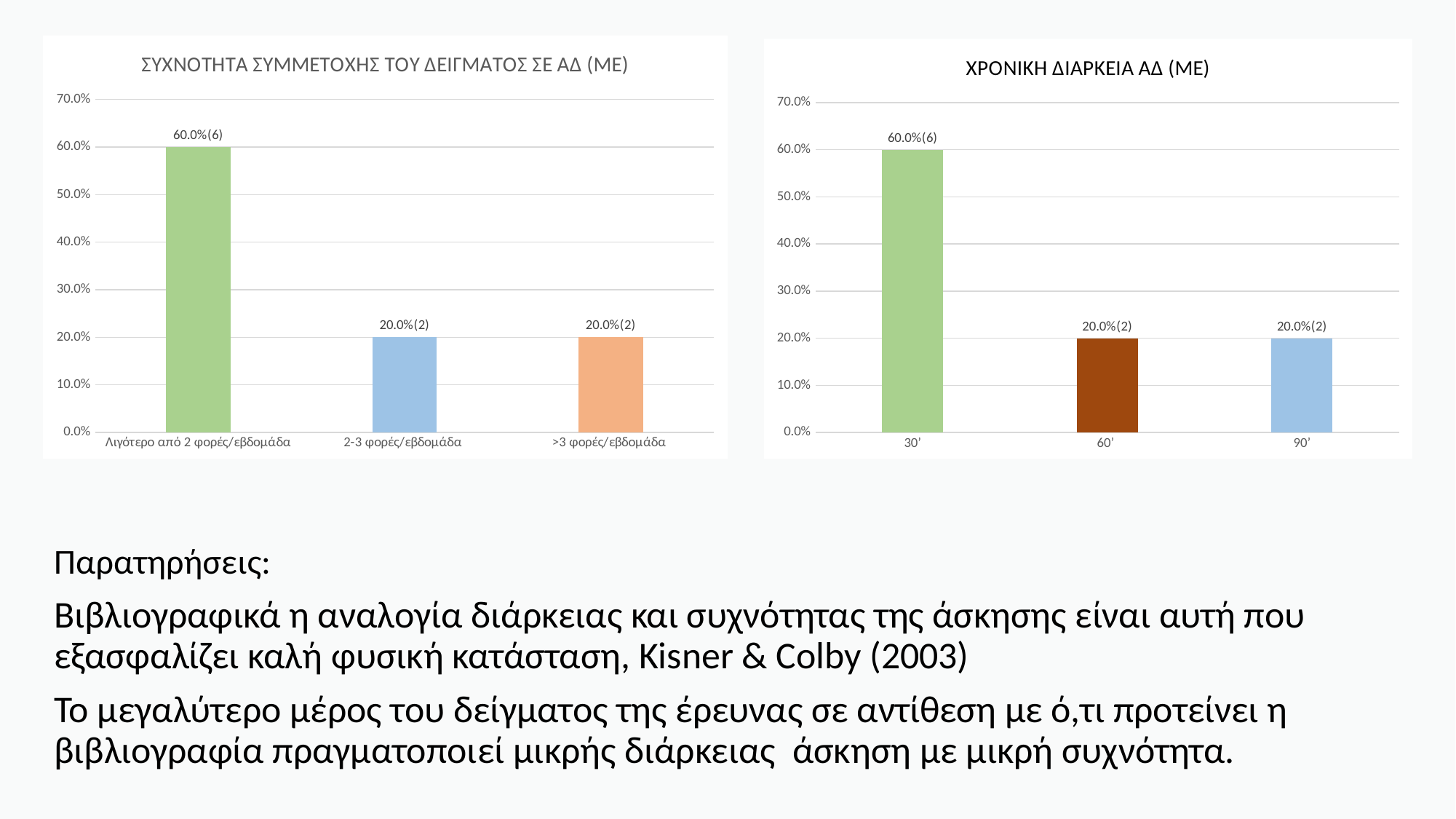
In the right chart (ΧΡΟΝΙΚΗ ΔΙΑΡΚΕΙΑ ΑΔ (ΜΕ)), which is larger, the value for 30’ or the value for 90’? 30’ In the left chart (ΣΥΧΝΟΤΗΤΑ ΣΥΜΜΕΤΟΧΗΣ ΤΟΥ ΔΕΙΓΜΑΤΟΣ ΣΕ ΑΔ (ΜΕ)), what is the value for '2-3 φορές/εβδομάδα'? 20.0%(2) In the left chart (ΣΥΧΝΟΤΗΤΑ ΣΥΜΜΕΤΟΧΗΣ ΤΟΥ ΔΕΙΓΜΑΤΟΣ ΣΕ ΑΔ (ΜΕ)), which category has the highest value? Λιγότερο από 2 φορές/εβδομάδα What kind of chart is the right chart (ΧΡΟΝΙΚΗ ΔΙΑΡΚΕΙΑ ΑΔ (ΜΕ))? Bar chart In the right chart (ΧΡΟΝΙΚΗ ΔΙΑΡΚΕΙΑ ΑΔ (ΜΕ)), what is the value for 60’? 20.0%(2) In the right chart (ΧΡΟΝΙΚΗ ΔΙΑΡΚΕΙΑ ΑΔ (ΜΕ)), which category has the highest value? 30’ In the left chart (ΣΥΧΝΟΤΗΤΑ ΣΥΜΜΕΤΟΧΗΣ ΤΟΥ ΔΕΙΓΜΑΤΟΣ ΣΕ ΑΔ (ΜΕ)), what is the difference in percentage between 'Λιγότερο από 2 φορές/εβδομάδα' and '>3 φορές/εβδομάδα'? 40.0% In the left chart (ΣΥΧΝΟΤΗΤΑ ΣΥΜΜΕΤΟΧΗΣ ΤΟΥ ΔΕΙΓΜΑΤΟΣ ΣΕ ΑΔ (ΜΕ)), how many categories are shown? 3 In the right chart (ΧΡΟΝΙΚΗ ΔΙΑΡΚΕΙΑ ΑΔ (ΜΕ)), is the value for 30’ greater or less than 50.0%? greater In the left chart (ΣΥΧΝΟΤΗΤΑ ΣΥΜΜΕΤΟΧΗΣ ΤΟΥ ΔΕΙΓΜΑΤΟΣ ΣΕ ΑΔ (ΜΕ)), what is the value for 'Λιγότερο από 2 φορές/εβδομάδα'? 60.0%(6) What is the title of the left chart? ΣΥΧΝΟΤΗΤΑ ΣΥΜΜΕΤΟΧΗΣ ΤΟΥ ΔΕΙΓΜΑΤΟΣ ΣΕ ΑΔ (ΜΕ) In the right chart (ΧΡΟΝΙΚΗ ΔΙΑΡΚΕΙΑ ΑΔ (ΜΕ)), what is the value for 30’? 60.0%(6)